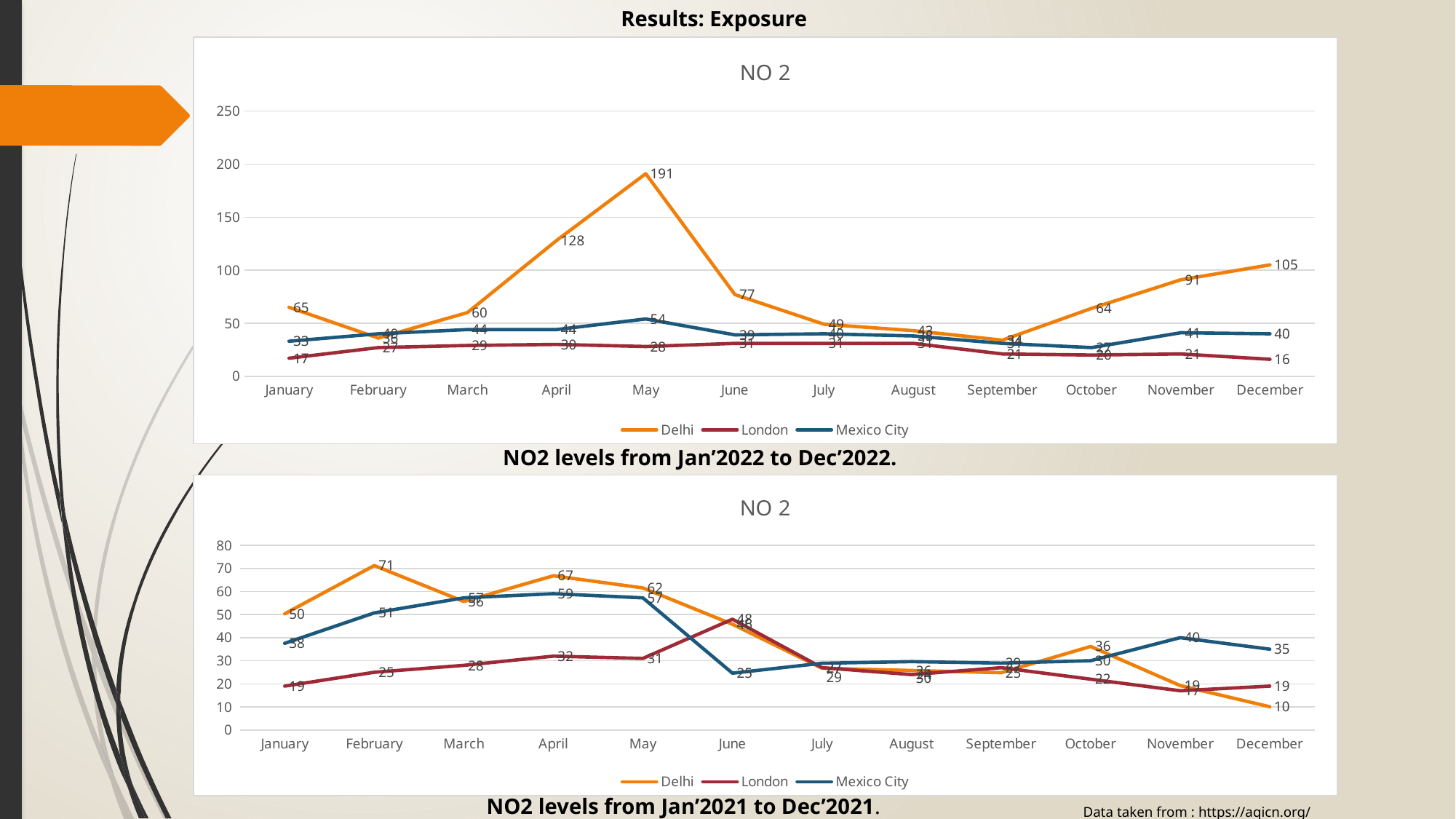
In the top chart (NO2 levels from Jan'2022 to Dec'2022), what is the value for Delhi in December? 105 How many months are shown on the x axis of the bottom chart (NO2 levels from Jan'2021 to Dec'2021)? 12 What kind of chart is the bottom chart (NO2 levels from Jan'2021 to Dec'2021)? line chart In the top chart (NO2 levels from Jan'2022 to Dec'2022), what is the difference between Delhi's May value and its April value? 63 In the top chart (NO2 levels from Jan'2022 to Dec'2022), is the value for Delhi in April greater or less than 100? greater In the top chart (NO2 levels from Jan'2022 to Dec'2022), in which month does Delhi reach its highest value? May In the bottom chart (NO2 levels from Jan'2021 to Dec'2021), does Delhi's value rise or fall from October to December? fall In the bottom chart (NO2 levels from Jan'2021 to Dec'2021), what is the value for Delhi in February? 71 In the top chart (NO2 levels from Jan'2022 to Dec'2022), what is the value for Delhi in May? 191 In the bottom chart (NO2 levels from Jan'2021 to Dec'2021), which is larger in November: Mexico City or Delhi? Mexico City In the top chart (NO2 levels from Jan'2022 to Dec'2022), how many series does the legend list? 3 In the bottom chart (NO2 levels from Jan'2021 to Dec'2021), what is the value for Delhi in December? 10